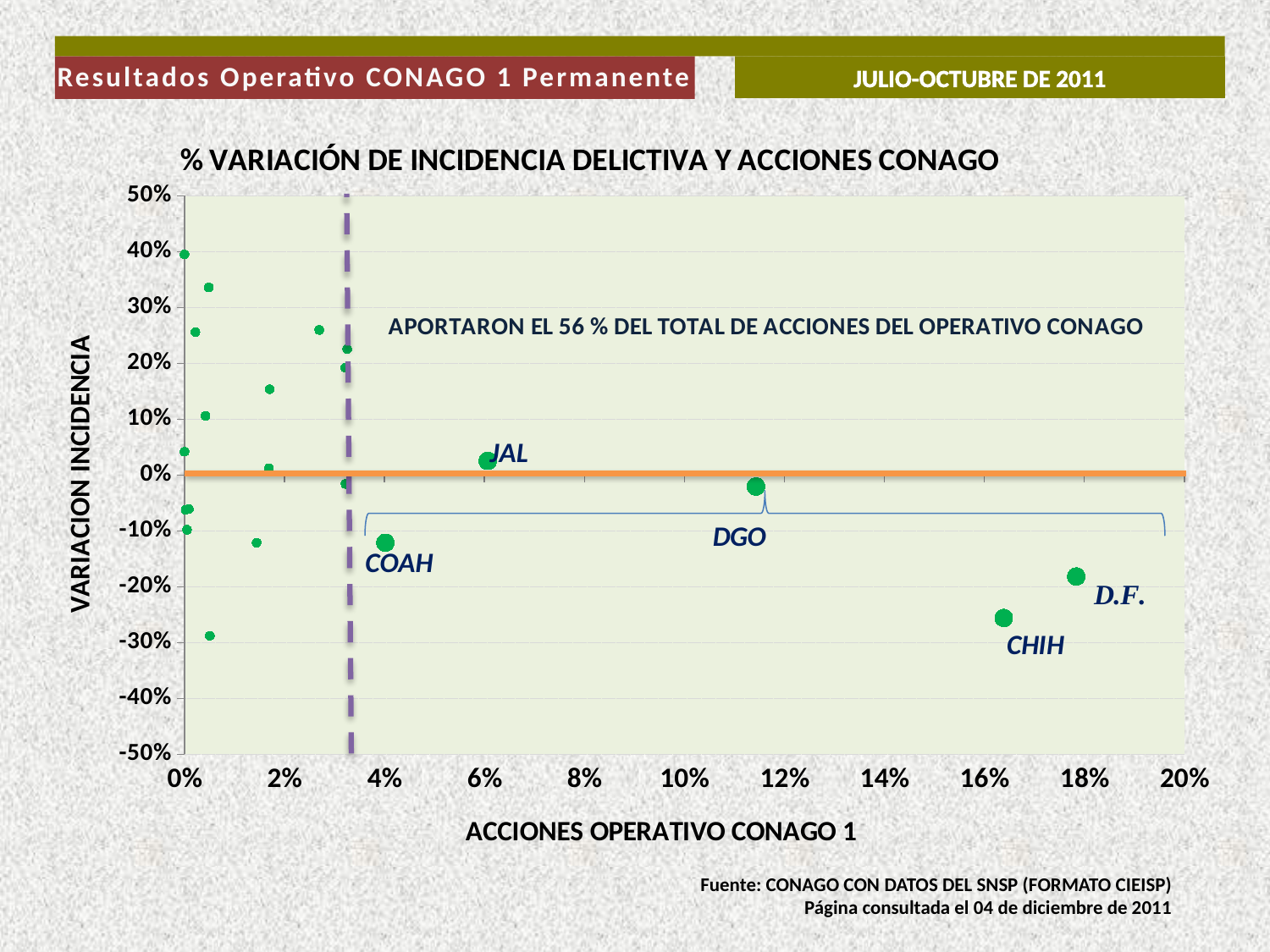
Among the labeled points, which has the highest VARIACION INCIDENCIA value? JAL Is the VARIACION INCIDENCIA value for COAH greater or less than 0%? less What is the title of the horizontal axis of the chart? ACCIONES OPERATIVO CONAGO 1 Is the ACCIONES OPERATIVO CONAGO 1 value for DGO greater or less than 10%? greater How many points on the chart are labeled with a state name? 5 Among the labeled points, which has the largest value on the ACCIONES OPERATIVO CONAGO 1 axis? D.F. Which has a higher VARIACION INCIDENCIA value, CHIH or D.F.? D.F. Is the VARIACION INCIDENCIA value for CHIH greater or less than -20%? less What kind of chart is shown on the slide? Scatter chart What is the title of the chart? % VARIACIÓN DE INCIDENCIA DELICTIVA Y ACCIONES CONAGO Among the labeled points, which has the lowest VARIACION INCIDENCIA value? CHIH